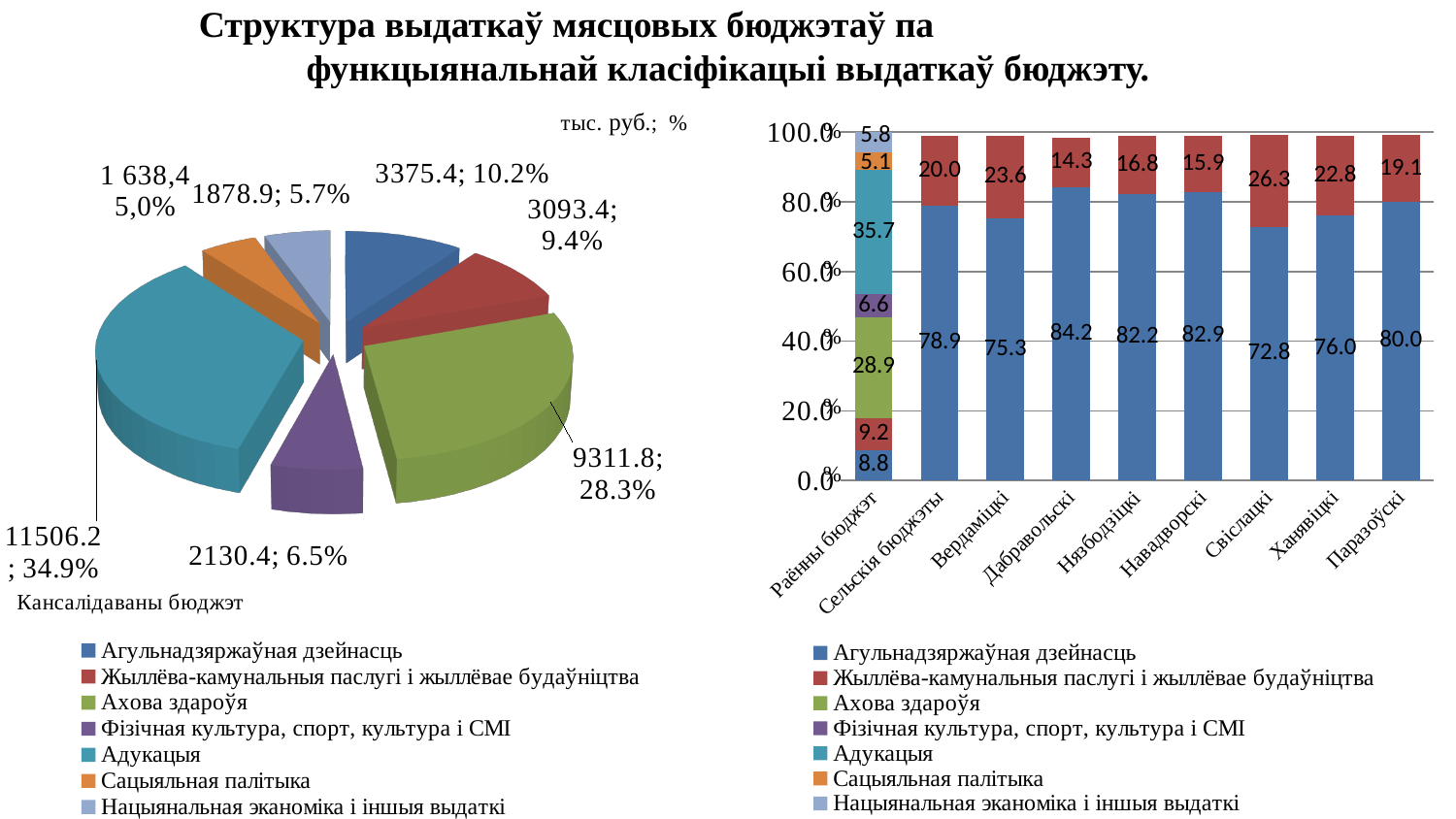
In the pie chart on the left, how many slices are there? 7 In the pie chart on the left, which category has the largest slice? Адукацыя In the stacked bar chart on the right, which category has the highest value for Жыллёва-камунальныя паслугі і жыллёвае будаўніцтва? Свіслацкі In the pie chart on the left, what is the value in thousand rubles for Ахова здароўя? 9311.8 In the pie chart on the left, which category has the smallest slice? Сацыяльная палітыка In the stacked bar chart on the right, how many categories are shown on the x axis? 9 In the stacked bar chart on the right, what is the value of Агульнадзяржаўная дзейнасць for Дабравольскі? 84.2 In the stacked bar chart on the right, what is the difference between the Агульнадзяржаўная дзейнасць values for Дабравольскі and Свіслацкі? 11.4 What type of chart is shown on the right side of the slide? Stacked bar chart In the pie chart on the left, what percentage share does Адукацыя have? 34.9% In the pie chart on the left, which is larger: Агульнадзяржаўная дзейнасць or Фізічная культура, спорт, культура і СМІ? Агульнадзяржаўная дзейнасць In the stacked bar chart on the right, what is the value of Адукацыя for Раённы бюджэт? 35.7